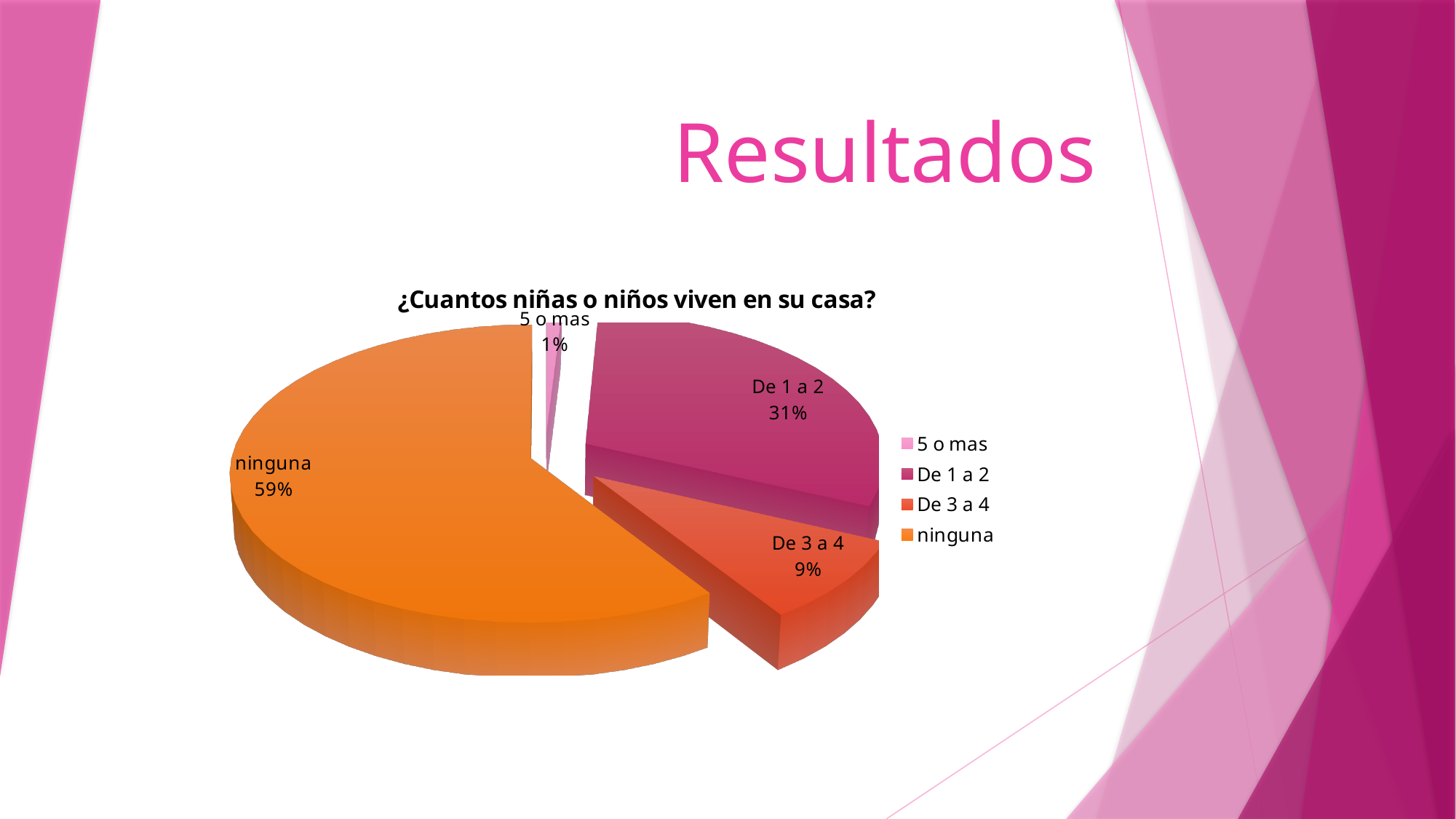
What percentage of the pie is the 'ninguna' slice? 59% Which is larger, the share for 'De 1 a 2' or the share for 'De 3 a 4'? De 1 a 2 How many entries does the legend list? 4 How many categories does the pie chart have? 4 What kind of chart is shown on the slide? Pie chart What percentage of the pie is the 'De 3 a 4' slice? 9% What percentage of the pie is the '5 o mas' slice? 1% What percentage of the pie is the 'De 1 a 2' slice? 31% Which category has the largest share of the pie? ninguna Which category has the smallest share of the pie? 5 o mas What is the title of the chart? ¿Cuantos niñas o niños viven en su casa? What is the difference in percentage points between 'ninguna' and 'De 1 a 2'? 28